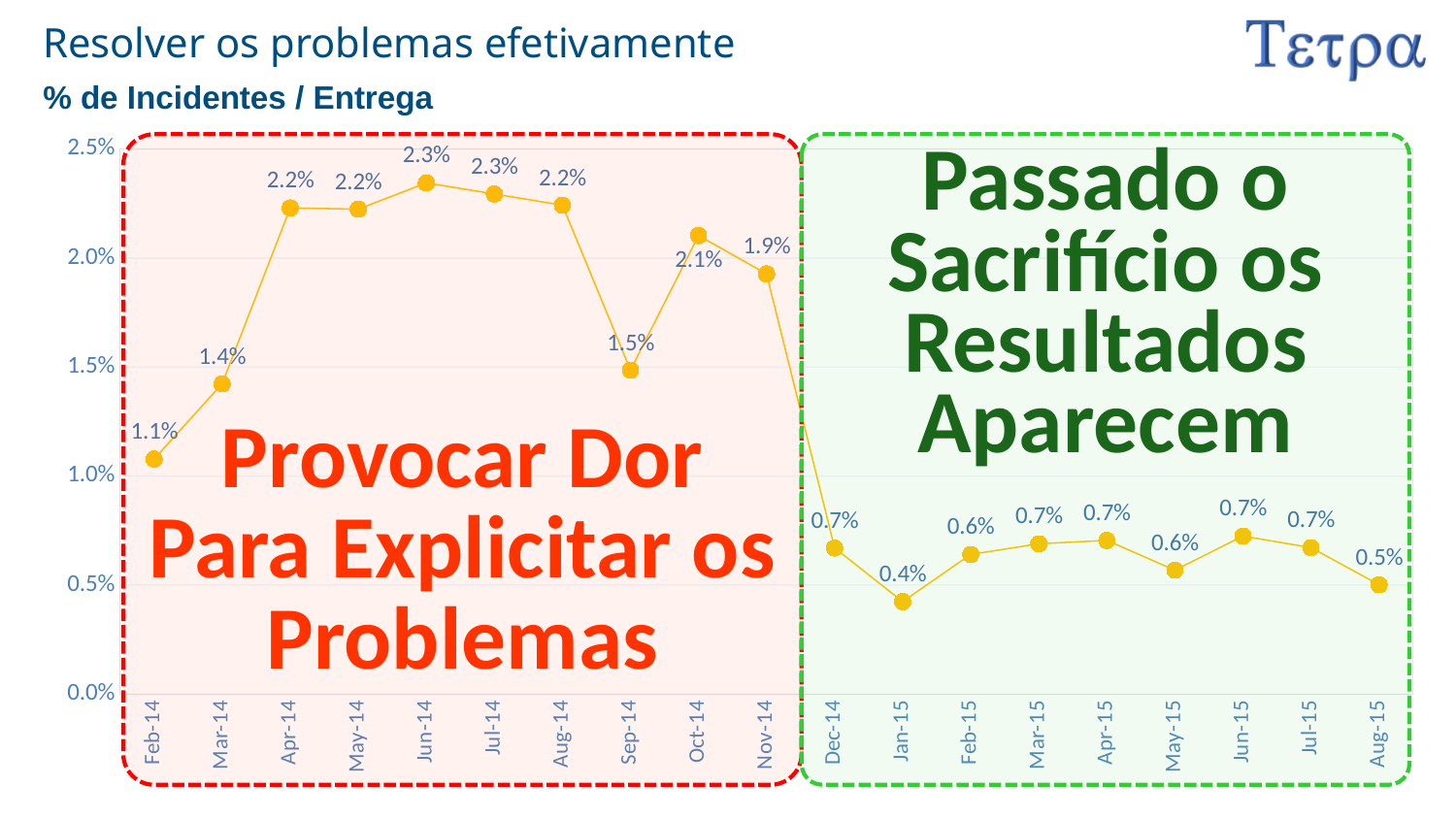
What is the value for Sep-14? 1.5% What is the difference between the values for Nov-14 and Dec-14? 1.2 percentage points What is the value for Jan-15? 0.4% Is the value for Apr-14 greater or less than 2.0%? greater What is the difference between the values for Mar-14 and Feb-14? 0.3 percentage points What is the value for Nov-14? 1.9% What is the title of the chart? % de Incidentes / Entrega Which is larger, the value for Oct-14 or the value for Sep-14? Oct-14 Which month has the lowest value? Jan-15 How many months are plotted on the x axis? 19 What is the value for Jun-14? 2.3% What kind of chart is shown? line chart